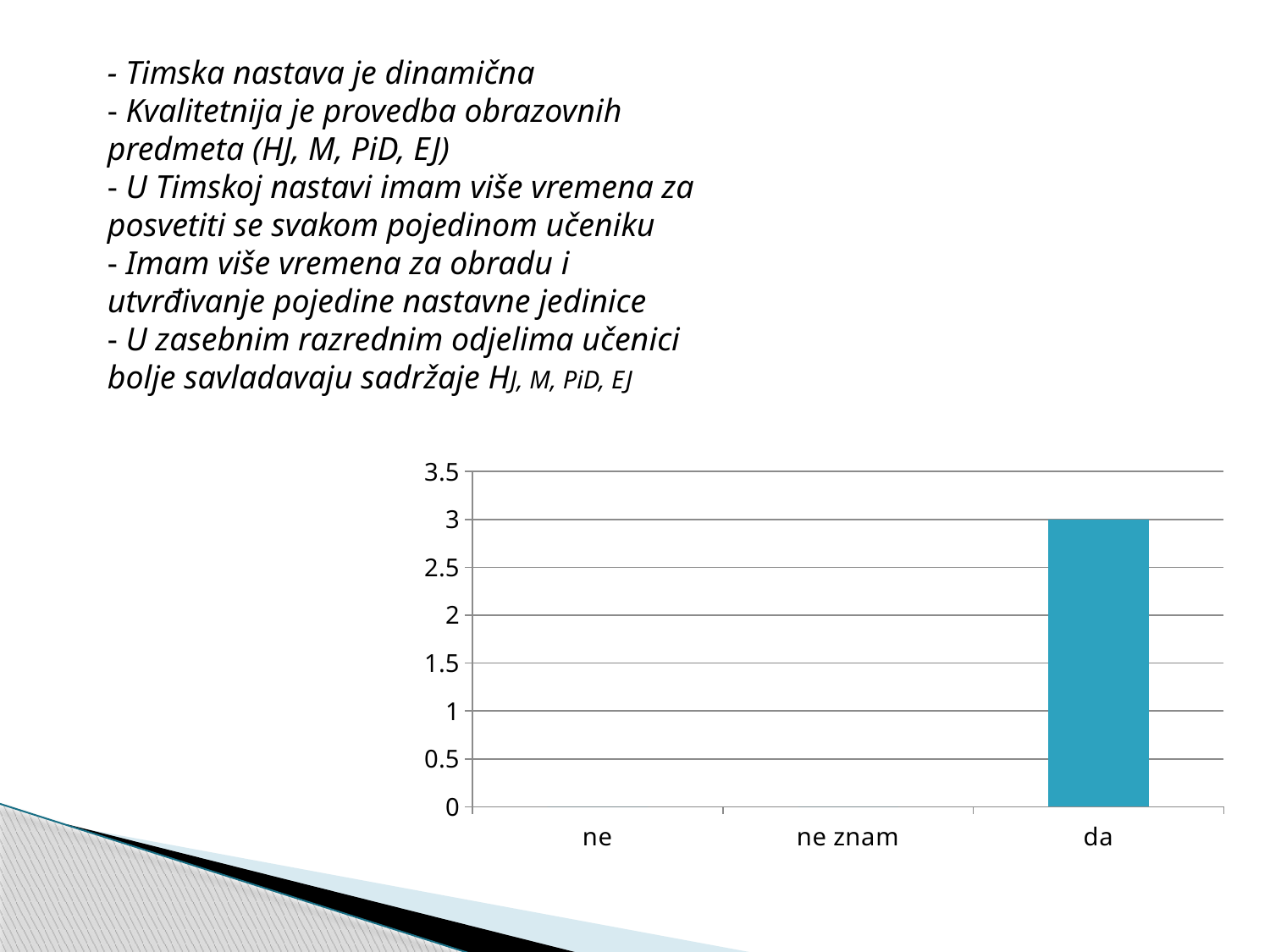
Which is larger, the value for "da" or the value for "ne"? da Which is larger, the value for "ne znam" or the value for "da"? da What is the value for "da" in the chart? 3 Which category has the highest value in the chart? da Is the value for "da" greater or less than 2? greater How many categories are shown on the x axis of the chart? 3 Is the value for "da" greater or less than 3.5? less What kind of chart is shown on the slide? bar chart What are the category labels on the x axis of the chart, from left to right? ne, ne znam, da What is the maximum value shown on the y axis of the chart? 3.5